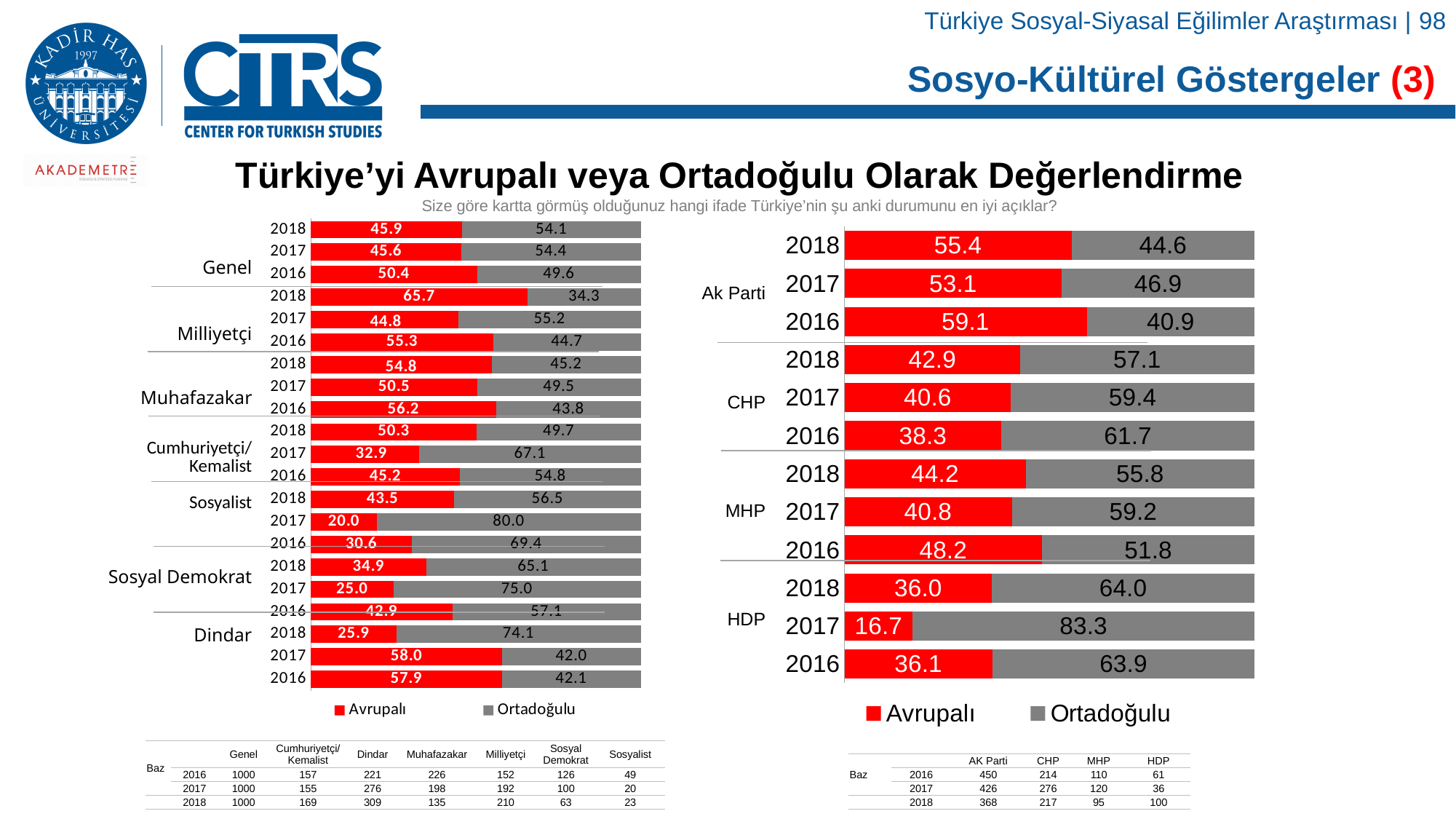
What type of chart is the right-hand chart? Stacked bar chart In the left-hand chart, which group-year bar has the highest Avrupalı value? Milliyetçi 2018 How many series does the legend of the right-hand chart list? 2 In the right-hand chart, what is the difference between the Avrupalı values for CHP in 2018 and CHP in 2016? 4.6 In the right-hand chart, what is the Avrupalı value for Ak Parti in 2018? 55.4 In the left-hand chart, which is larger: the Avrupalı value for Dindar in 2017 or for Dindar in 2018? Dindar 2017 In the left-hand chart, what is the Ortadoğulu value for Sosyalist in 2017? 80.0 In the right-hand chart, what is the total of the Avrupalı and Ortadoğulu values for MHP in 2016? 100.0 In the left-hand chart, what is the Avrupalı value for Milliyetçi in 2018? 65.7 In the right-hand chart, which party-year bar has the lowest Avrupalı value? HDP 2017 In the right-hand chart, what is the Ortadoğulu value for HDP in 2017? 83.3 In the left-hand chart, how does the Avrupalı value for Genel change from 2016 to 2018? It falls (50.4 to 45.9)